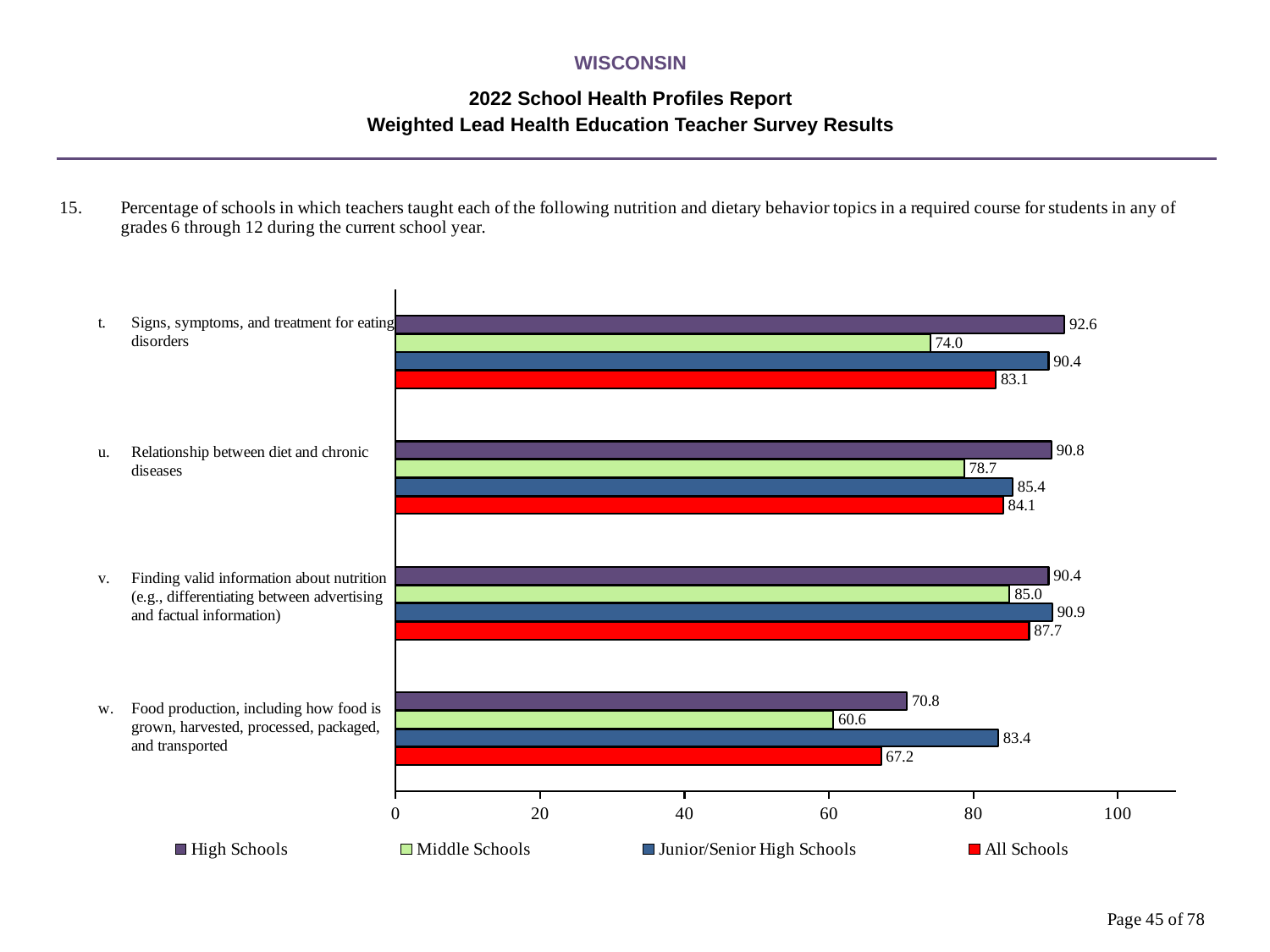
What is the All Schools value for the relationship between diet and chronic diseases? 84.1 What percentage of High Schools taught signs, symptoms, and treatment for eating disorders? 92.6 What is the difference between the High Schools and Middle Schools values for signs, symptoms, and treatment for eating disorders? 18.6 What is the value for Middle Schools for food production, including how food is grown, harvested, processed, packaged, and transported? 60.6 How many series does the legend list? 4 Which topic has the lowest All Schools value? Food production, including how food is grown, harvested, processed, packaged, and transported What is the Junior/Senior High Schools value for finding valid information about nutrition? 90.9 Which school type has the highest value for signs, symptoms, and treatment for eating disorders? High Schools How many nutrition and dietary behavior topics are shown on the chart? 4 What kind of chart is shown on the slide? Bar chart Which colour represents All Schools in the legend? Red For food production, which is larger: the Junior/Senior High Schools value or the High Schools value? Junior/Senior High Schools